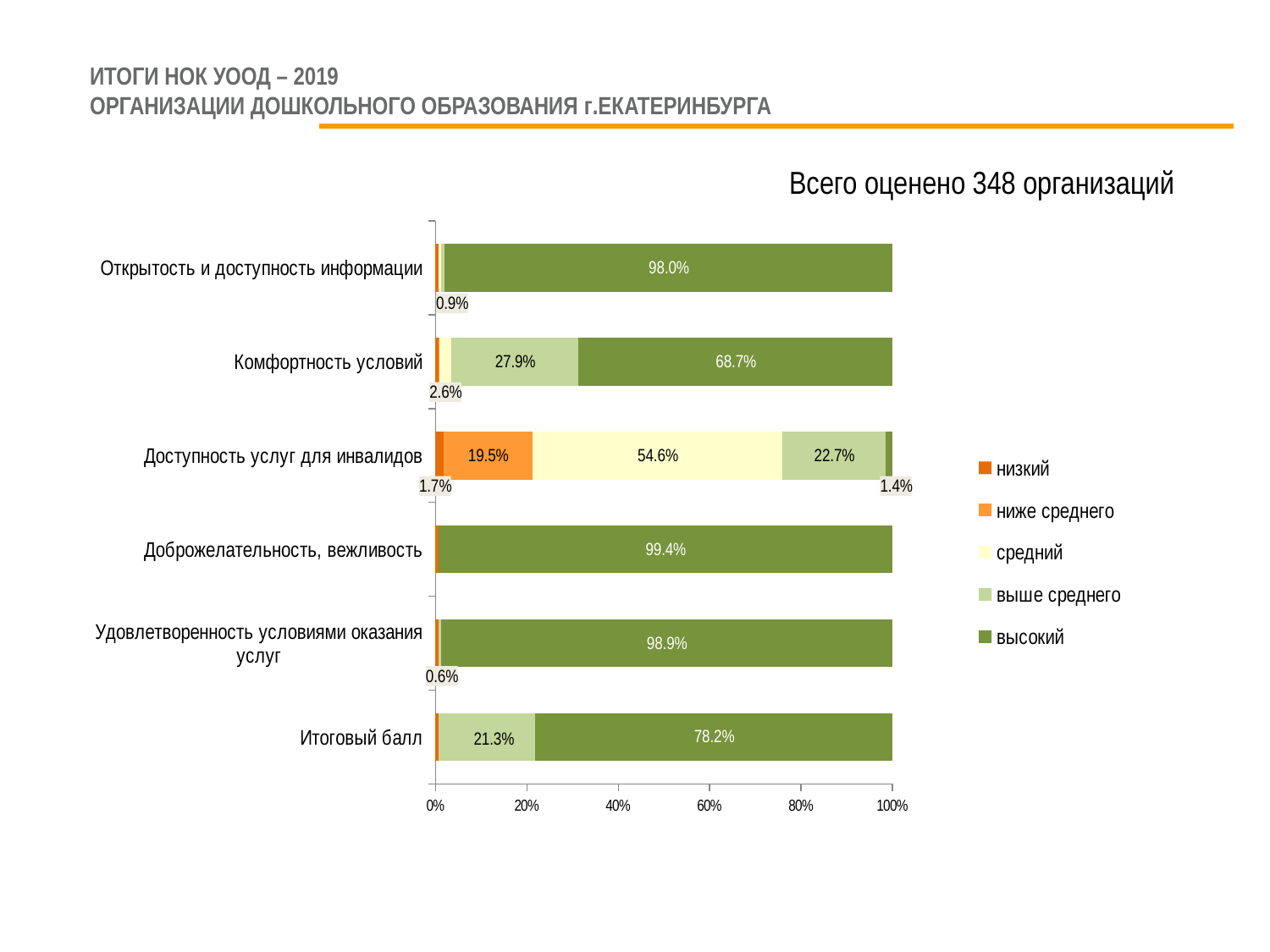
What is the difference between the 'высокий' values for 'Открытость и доступность информации' and 'Комфортность условий'? 29.3% Which category has the lowest value for the 'высокий' series? Доступность услуг для инвалидов What kind of chart is shown on the slide? Stacked bar chart How many categories are plotted on the chart? 6 Which category has the highest value for the 'высокий' series? Доброжелательность, вежливость What is the value of the 'ниже среднего' series for 'Доступность услуг для инвалидов'? 19.5% What is the value of the 'средний' series for 'Доступность услуг для инвалидов'? 54.6% Which is larger: the 'выше среднего' value for 'Комфортность условий' or for 'Итоговый балл'? Комфортность условий How many series does the legend list? 5 What is the value of the 'высокий' series for 'Итоговый балл'? 78.2% What is the value of the 'выше среднего' series for 'Комфортность условий'? 27.9% What is the value of the 'высокий' series for 'Открытость и доступность информации'? 98.0%